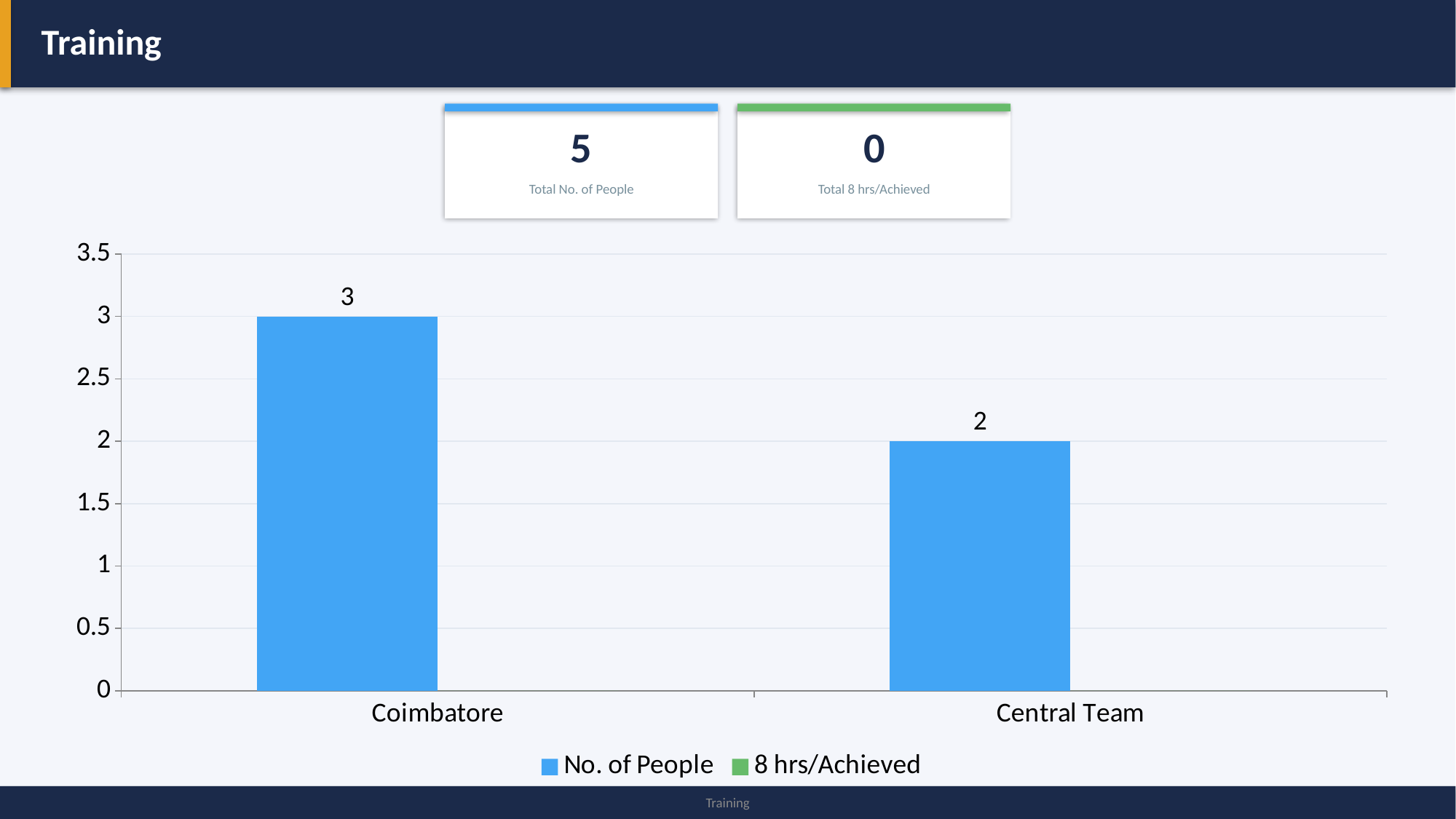
What is the value for No. of People for Central Team? 2 Which category has the highest No. of People? Coimbatore What colour are the No. of People bars? blue Which category has the lowest No. of People? Central Team How many series does the legend list? 2 Which has more No. of People, Coimbatore or Central Team? Coimbatore Do the No. of People values rise or fall from Coimbatore to Central Team? fall What is the value for No. of People for Coimbatore? 3 What is the difference in No. of People between Coimbatore and Central Team? 1 Is the value for No. of People for Coimbatore greater or less than 2.5? greater What kind of chart is shown on the slide? bar chart How many categories are shown on the x axis? 2